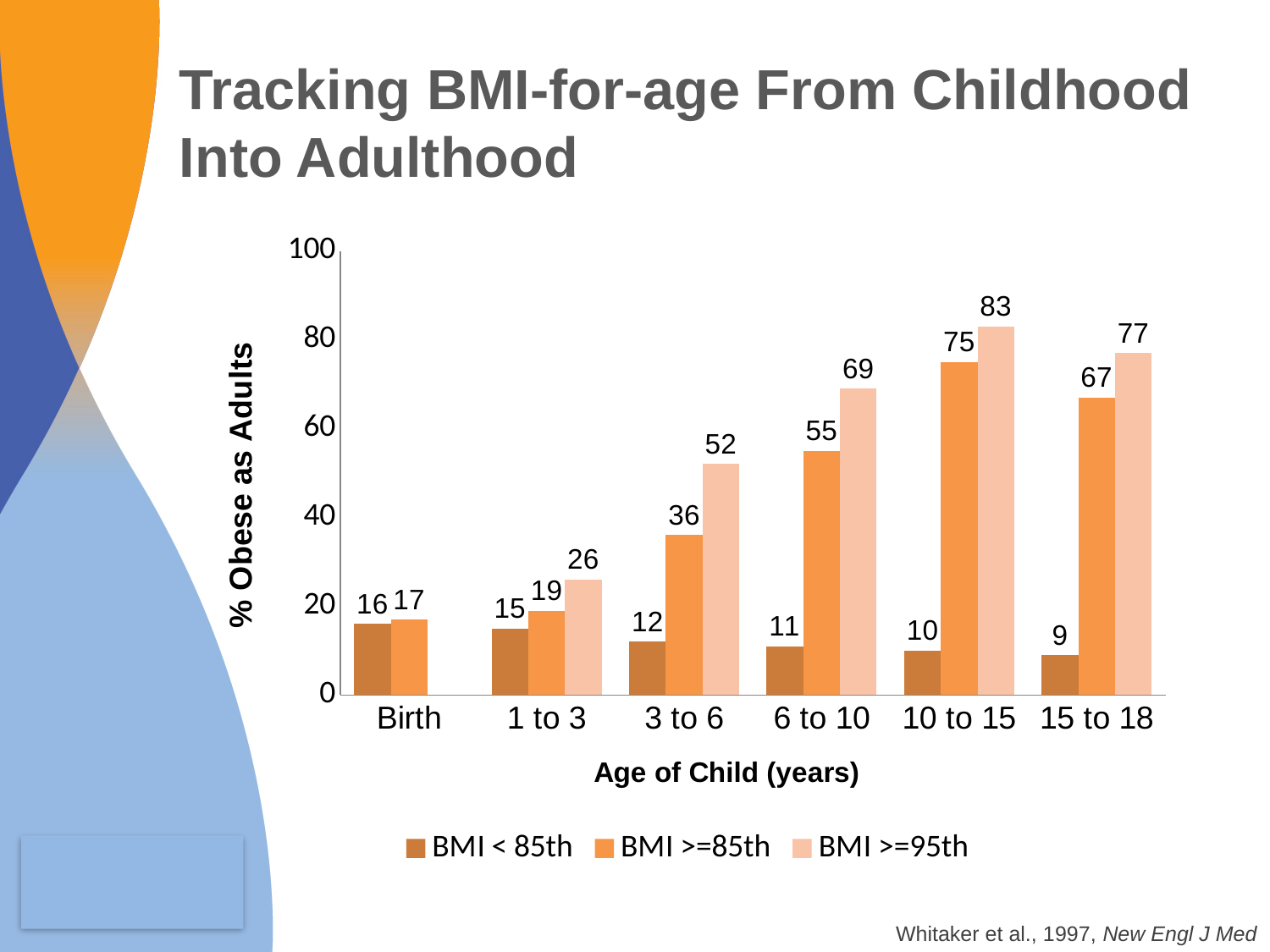
What is the value for BMI >=85th at age 3 to 6? 36 What is the value for BMI >=95th at age 10 to 15? 83 Which age group has the lowest value for BMI < 85th? 15 to 18 What is the difference between the BMI >=95th and BMI < 85th values at age 15 to 18? 68 What kind of chart is shown on the slide? Bar chart How many series does the legend list? 3 What is the label of the y axis? % Obese as Adults How many age groups are shown on the x axis? 6 Do the values for BMI < 85th rise or fall from Birth to 15 to 18? Fall What is the value for BMI < 85th at age 6 to 10? 11 Which age group has the highest value for BMI >=95th? 10 to 15 Which is larger at age 6 to 10: the BMI >=85th value or the BMI >=95th value? BMI >=95th